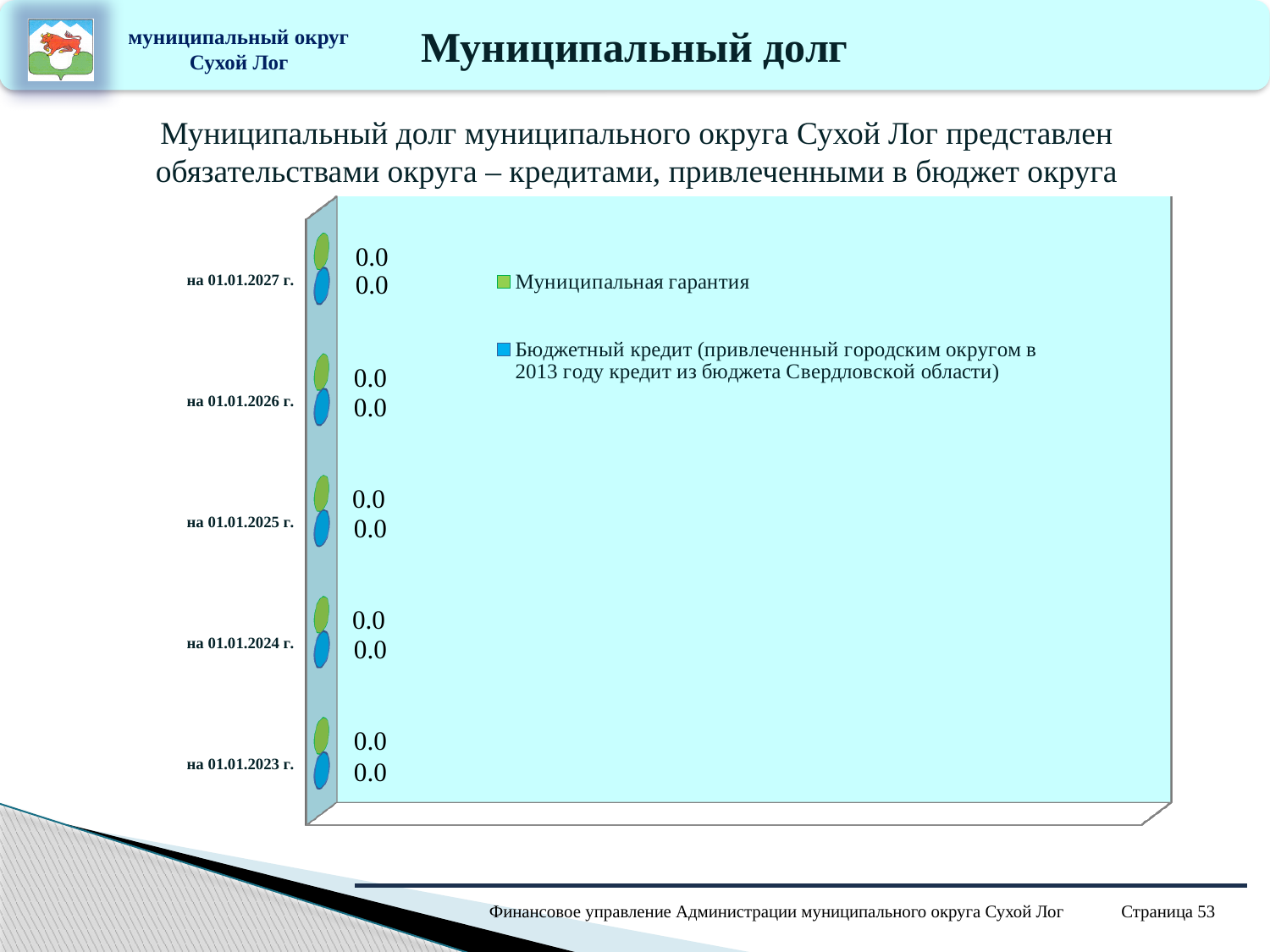
What is the value of Бюджетный кредит for на 01.01.2024 г.? 0.0 What is the difference between the Бюджетный кредит values for на 01.01.2026 г. and на 01.01.2023 г.? 0.0 How many date categories are shown on the chart? 5 Which colour represents Муниципальная гарантия in the legend? green What is the value of Муниципальная гарантия for на 01.01.2027 г.? 0.0 What is the total of the two series for на 01.01.2025 г.? 0.0 What is the value of Муниципальная гарантия for на 01.01.2023 г.? 0.0 How many series does the legend list? 2 What is the value of Бюджетный кредит for на 01.01.2025 г.? 0.0 Do the Муниципальная гарантия values rise, fall or stay the same from на 01.01.2023 г. to на 01.01.2027 г.? stay the same What kind of chart is shown on the slide? bar chart What is the first legend entry of the chart? Муниципальная гарантия